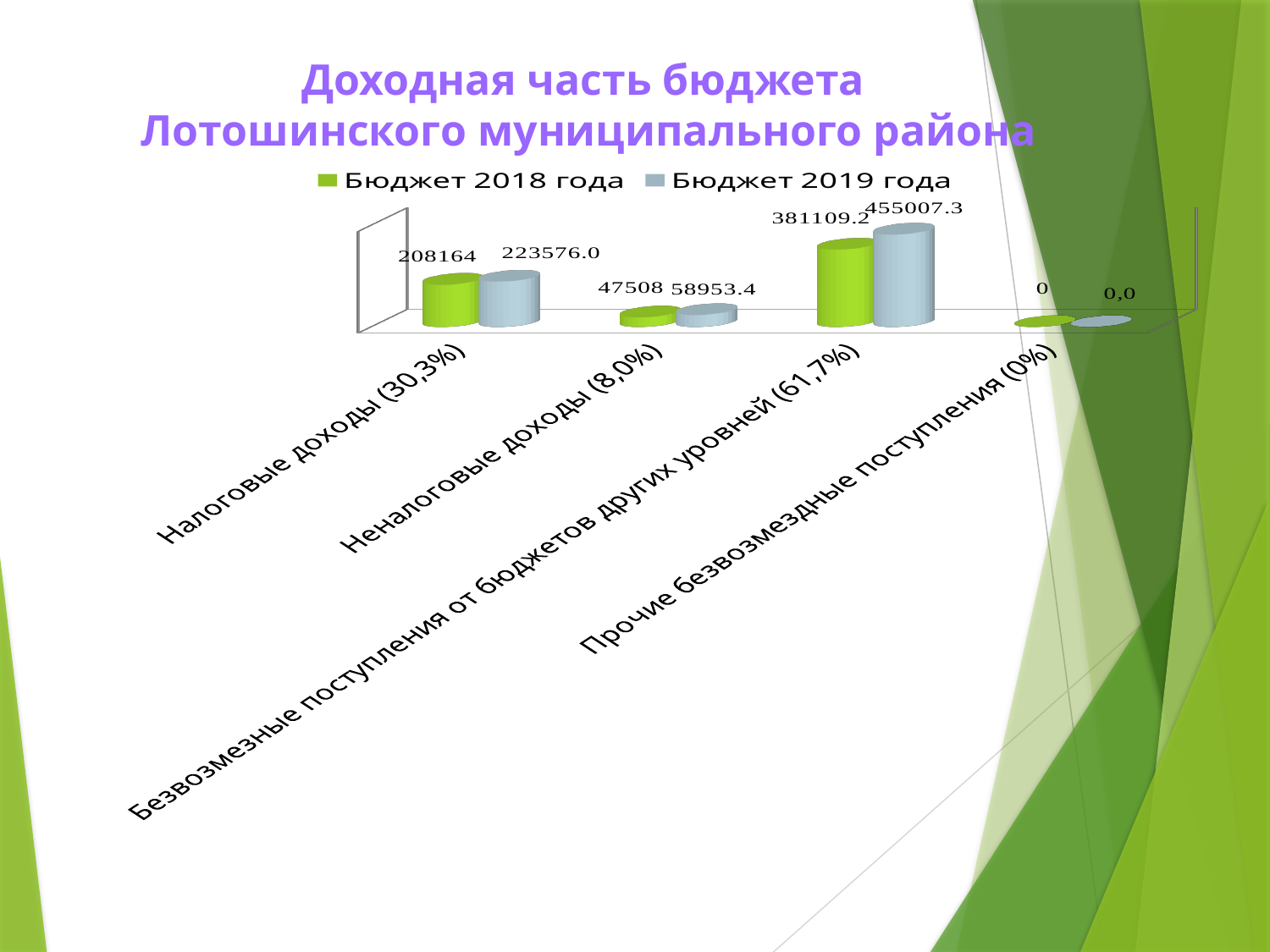
Which is larger for Безвозмездные поступления от бюджетов других уровней (61,7%): the Бюджет 2018 года value or the Бюджет 2019 года value? Бюджет 2019 года Which category has the highest value in the Бюджет 2018 года series? Безвозмездные поступления от бюджетов других уровней (61,7%) Which category has the lowest value in the Бюджет 2019 года series? Прочие безвозмездные поступления (0%) How many categories are shown on the x axis? 4 What is the value for Безвозмездные поступления от бюджетов других уровней (61,7%) in the Бюджет 2019 года series? 455007.3 What is the difference between the Бюджет 2019 года and Бюджет 2018 года values for Неналоговые доходы (8,0%)? 11445.4 What is the value for Налоговые доходы (30,3%) in the Бюджет 2019 года series? 223576.0 What is the value for Неналоговые доходы (8,0%) in the Бюджет 2018 года series? 47508 What kind of chart is shown on the slide? Bar chart How many series does the legend list? 2 What is the value for Неналоговые доходы (8,0%) in the Бюджет 2019 года series? 58953.4 What is the value for Налоговые доходы (30,3%) in the Бюджет 2018 года series? 208164